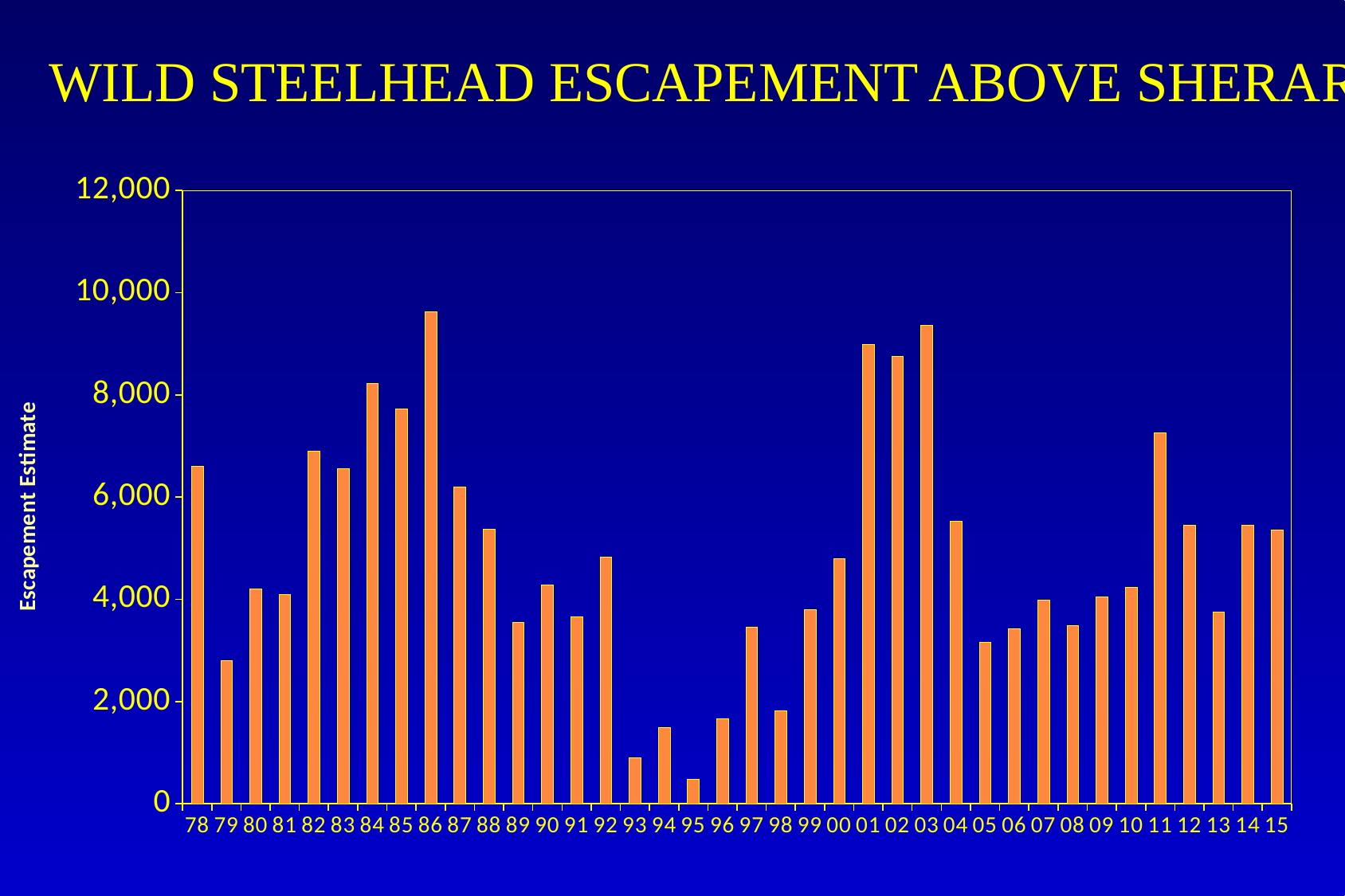
What is the label on the vertical axis? Escapement Estimate Which year has the lowest escapement estimate? 95 What kind of chart is shown on the slide? bar chart Is the escapement estimate for 86 greater or less than 8,000? greater Is the escapement estimate for 01 greater or less than 8,000? greater Is the escapement estimate for 11 greater or less than 6,000? greater Do the escapement estimates rise or fall from 92 to 95? fall Which year has the larger escapement estimate, 11 or 12? 11 How many years (bars) are plotted on the chart? 38 Which year has the larger escapement estimate, 84 or 85? 84